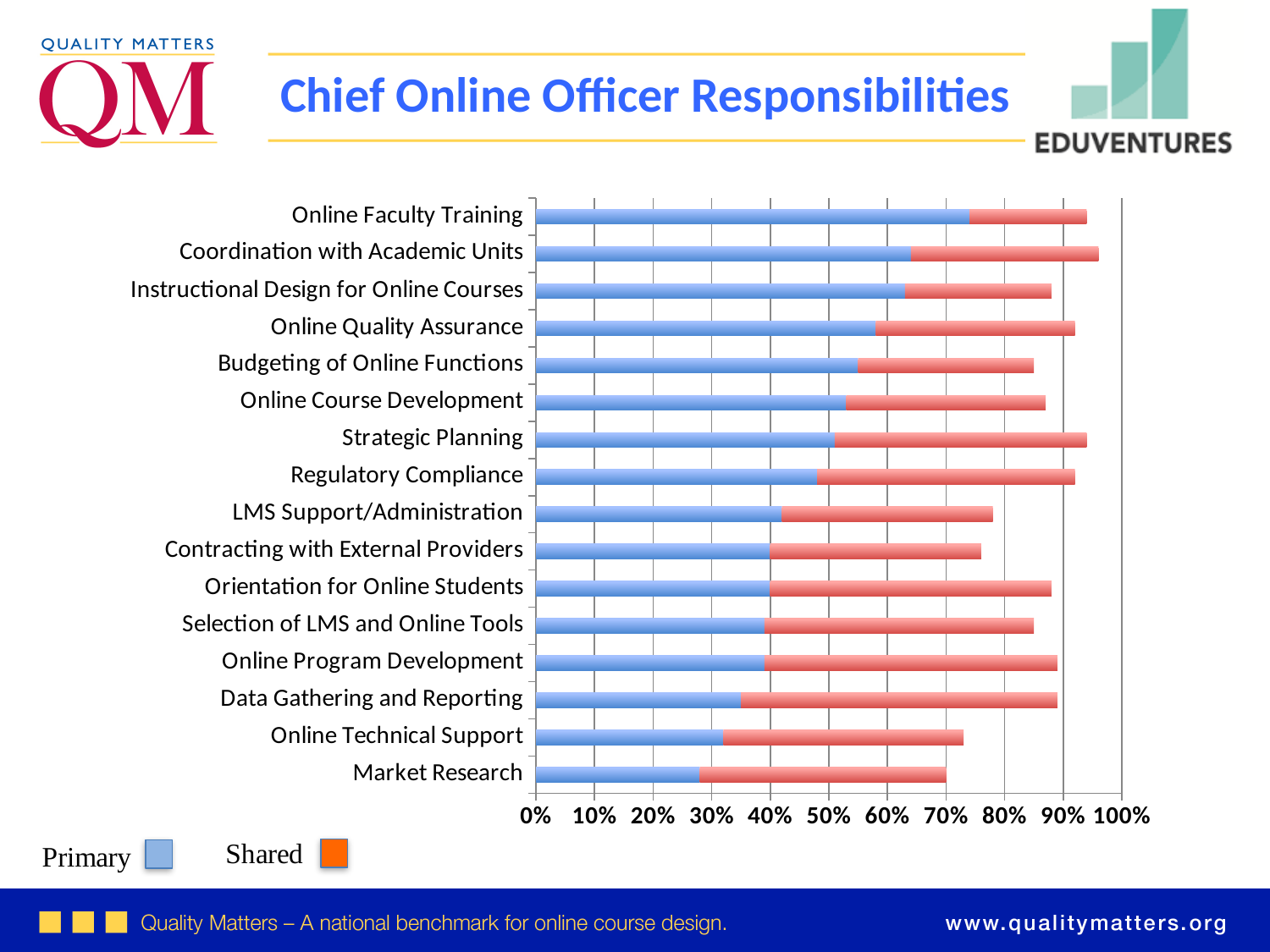
Which responsibility has the largest Primary (blue) segment? Online Faculty Training How many responsibility categories are listed on the chart? 16 How many series does the legend list? 2 Is the Primary value for Online Faculty Training greater or less than 70%? greater What kind of chart is shown on the slide? Stacked bar chart Is the Primary value for Market Research greater or less than 40%? less What colour represents the Primary series in the legend? Blue Is the Primary value for Strategic Planning greater or less than 40%? greater Do the Primary (blue) values rise or fall going down the list from Online Faculty Training to Market Research? fall Which has the longer total bar: Coordination with Academic Units or Online Technical Support? Coordination with Academic Units Which responsibility has the smallest Primary (blue) segment? Market Research